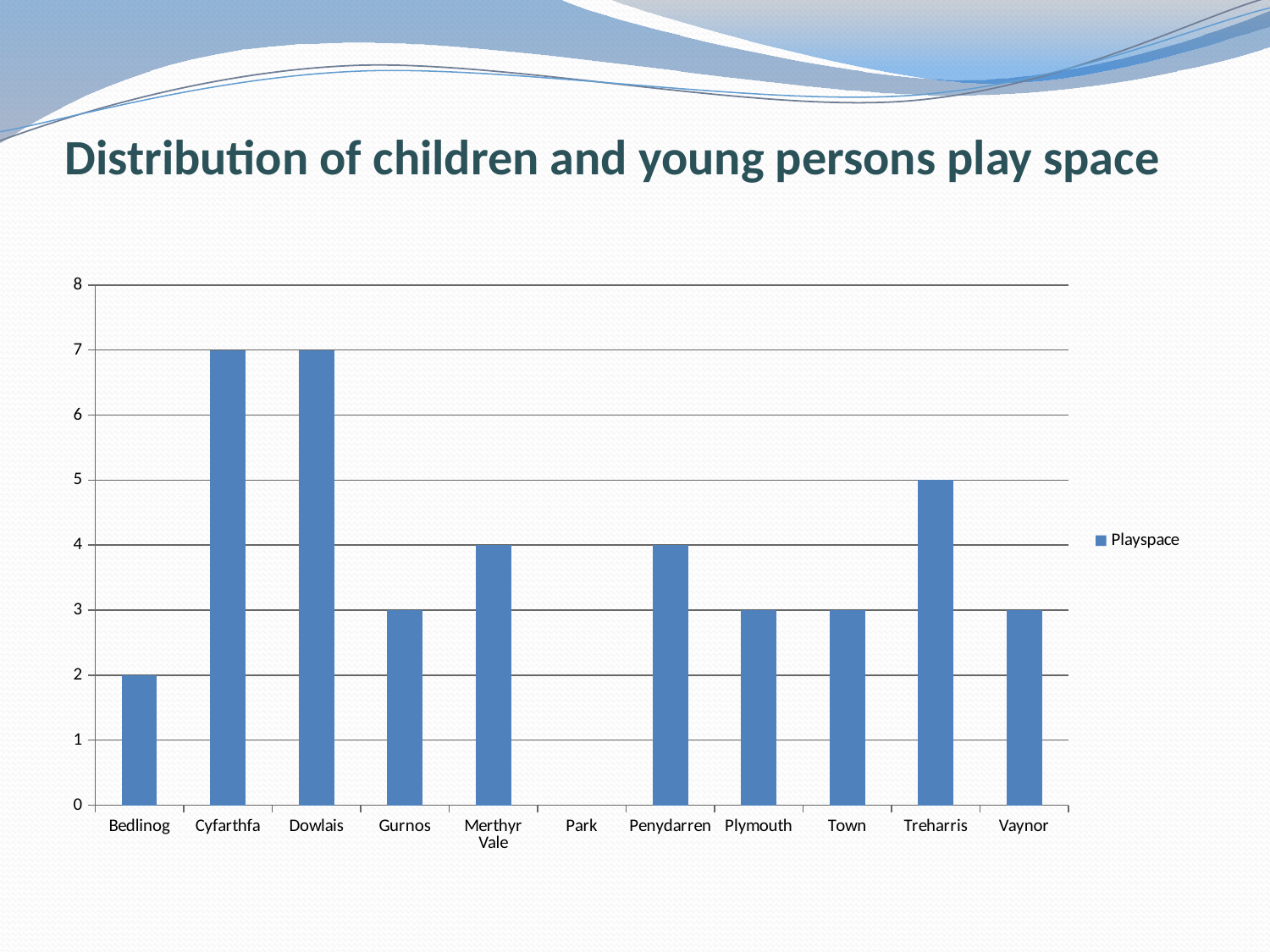
What is the Playspace value for Merthyr Vale? 4 What is the Playspace value for Treharris? 5 What is the title of the chart? Distribution of children and young persons play space Which has a larger Playspace value, Treharris or Penydarren? Treharris Is the Playspace value for Dowlais greater or less than 6? greater What type of chart is shown on the slide? Bar chart Which category has the lowest Playspace value? Park What is the difference between the Playspace values for Cyfarthfa and Bedlinog? 5 How many categories are shown on the x axis? 11 What is the Playspace value for Gurnos? 3 How many series does the legend list? 1 What is the Playspace value for Bedlinog? 2